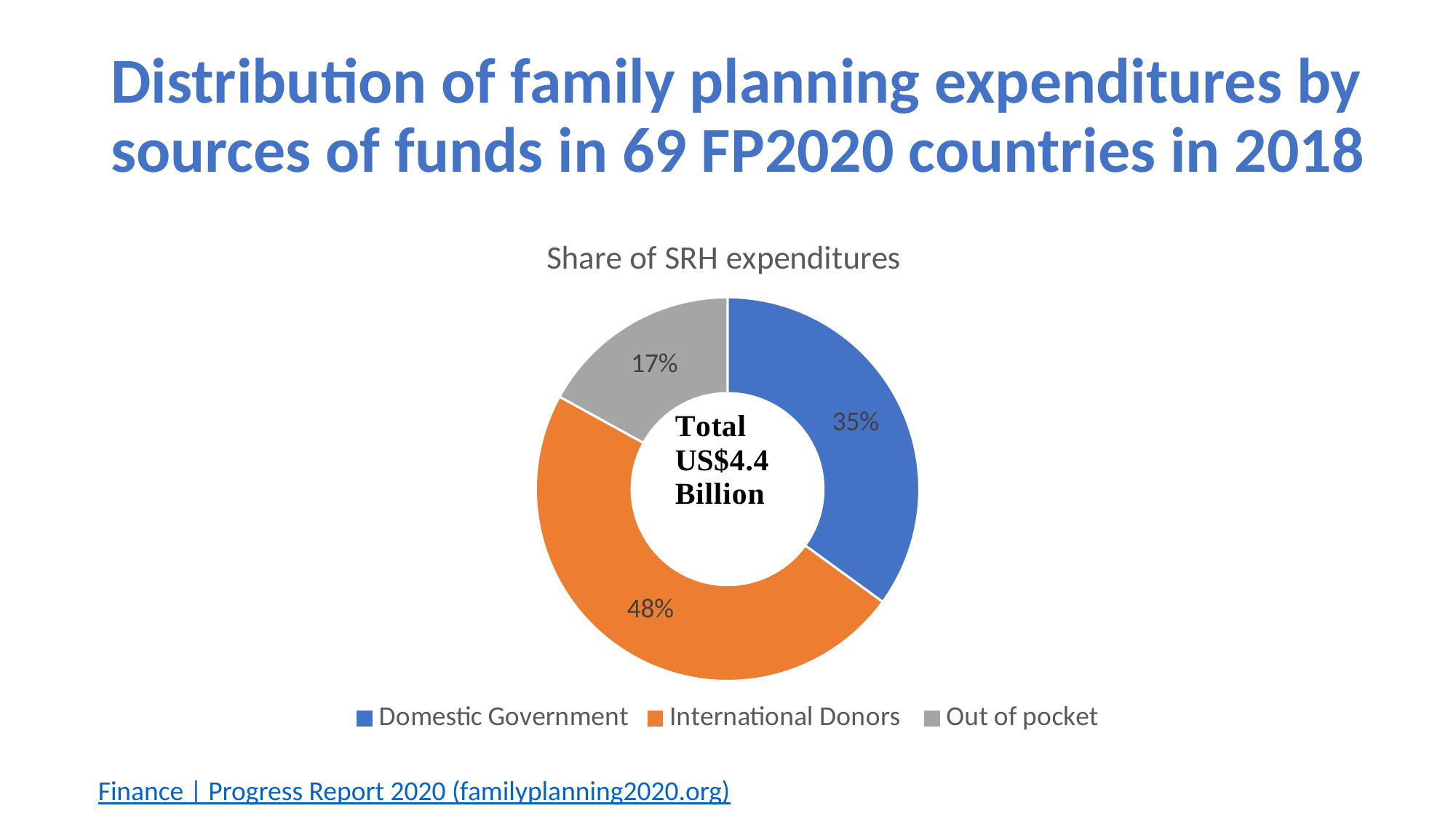
What is the total expenditure shown in the centre of the chart? US$4.4 Billion What kind of chart is shown on the slide? Doughnut (pie) chart Which is larger, the Domestic Government share or the Out of pocket share? Domestic Government What is the combined share of Domestic Government and Out of pocket? 52% What share of SRH expenditures comes from International Donors? 48% How many percentage points larger is the International Donors share than the Domestic Government share? 13 percentage points How many sources of funds are shown in the chart? 3 What is the title of the chart? Share of SRH expenditures Which source of funds has the smallest share of SRH expenditures? Out of pocket Which source of funds has the largest share of SRH expenditures? International Donors What share of SRH expenditures comes from Domestic Government? 35% What share of SRH expenditures is Out of pocket? 17%